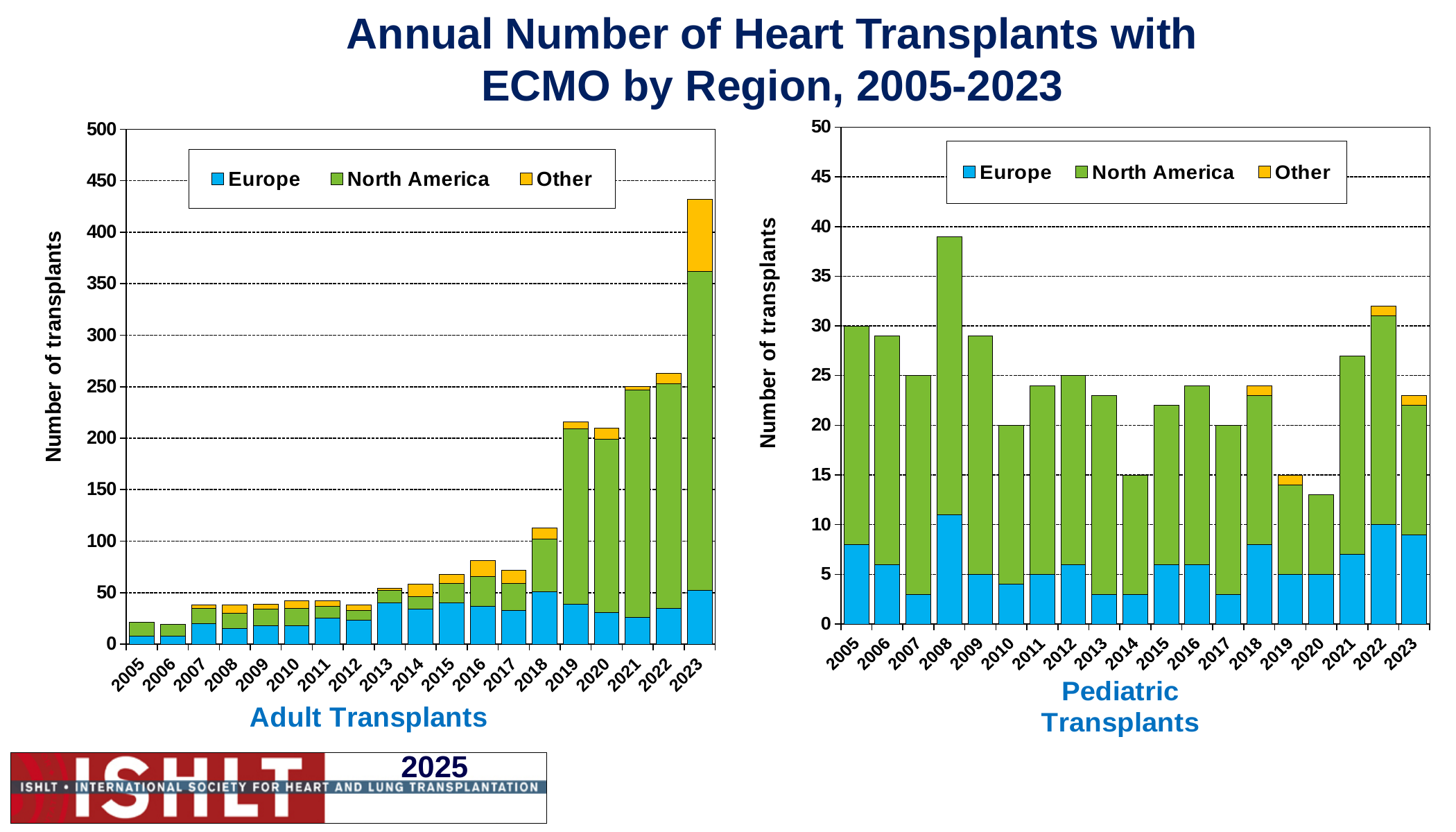
Which series is shown in green in both charts? North America In the Adult Transplants chart, which year has the larger total, 2022 or 2023? 2023 In the Adult Transplants chart, do the total numbers of transplants generally rise or fall from 2005 to 2023? rise In the Adult Transplants chart, which year has the highest total number of transplants? 2023 How many years are shown on the x axis of the Adult Transplants chart? 19 In the Adult Transplants chart, is the total for 2005 greater or less than 50? less In the Pediatric Transplants chart, is the total for 2008 greater or less than 35? greater In the Pediatric Transplants chart, which year has the highest total number of transplants? 2008 How many series does the legend of the Pediatric Transplants chart list? 3 What kind of chart is the Adult Transplants chart? bar chart In the Adult Transplants chart, is the total for 2023 greater or less than 400? greater In the Pediatric Transplants chart, which year has the lowest total number of transplants? 2020